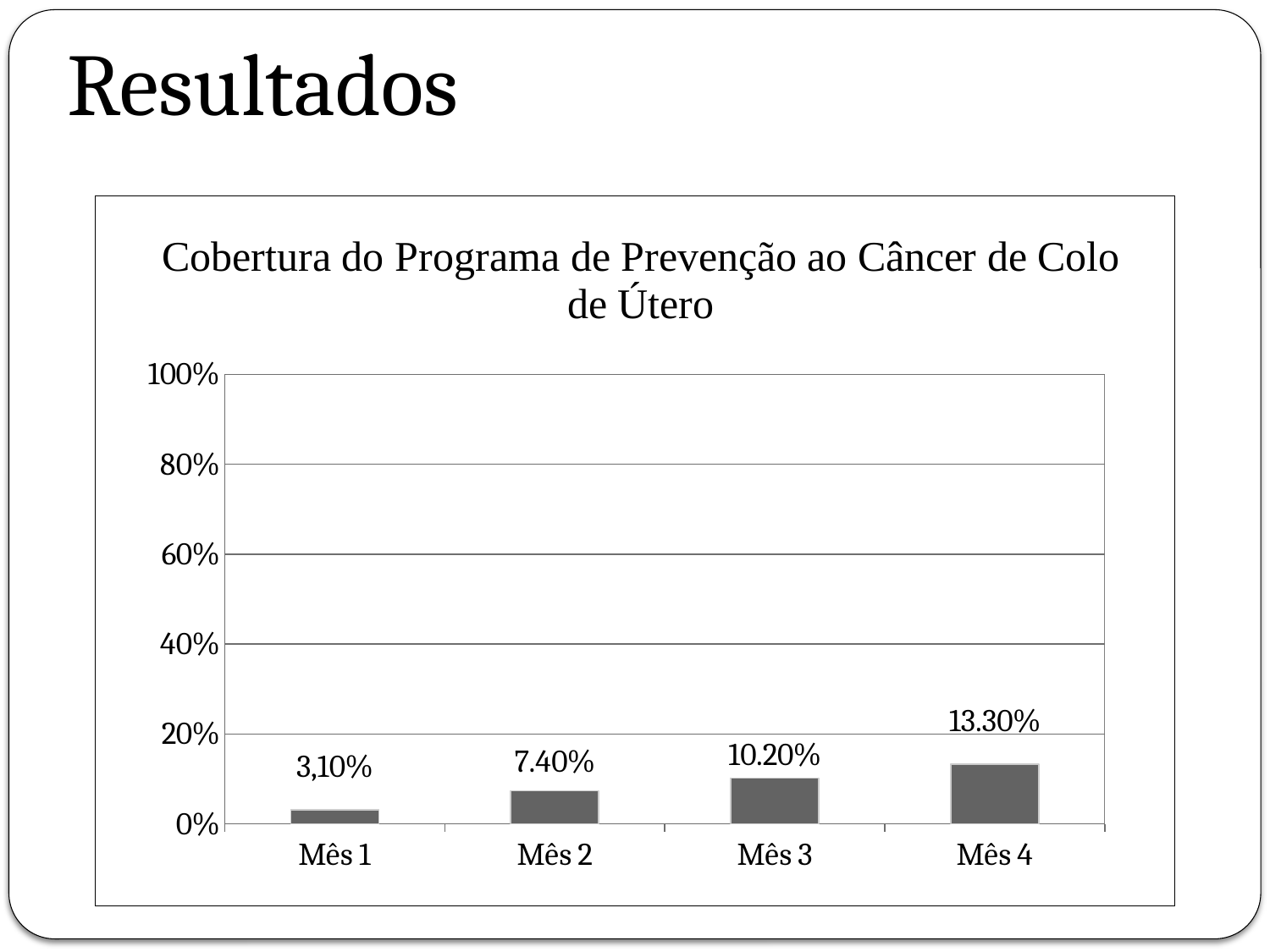
Which month has the lowest coverage value? Mês 1 Is the value for Mês 4 greater or less than 20%? less How many months are shown on the x axis? 4 What is the value for Mês 4? 13.30% What is the value for Mês 1? 3,10% Which is larger, the value for Mês 2 or the value for Mês 3? Mês 3 What is the value for Mês 3? 10.20% What is the value for Mês 2? 7.40% What is the difference between the values for Mês 4 and Mês 3? 3.10% What is the difference between the values for Mês 3 and Mês 2? 2.80% Which month has the highest coverage value? Mês 4 What kind of chart is shown on the slide? bar chart